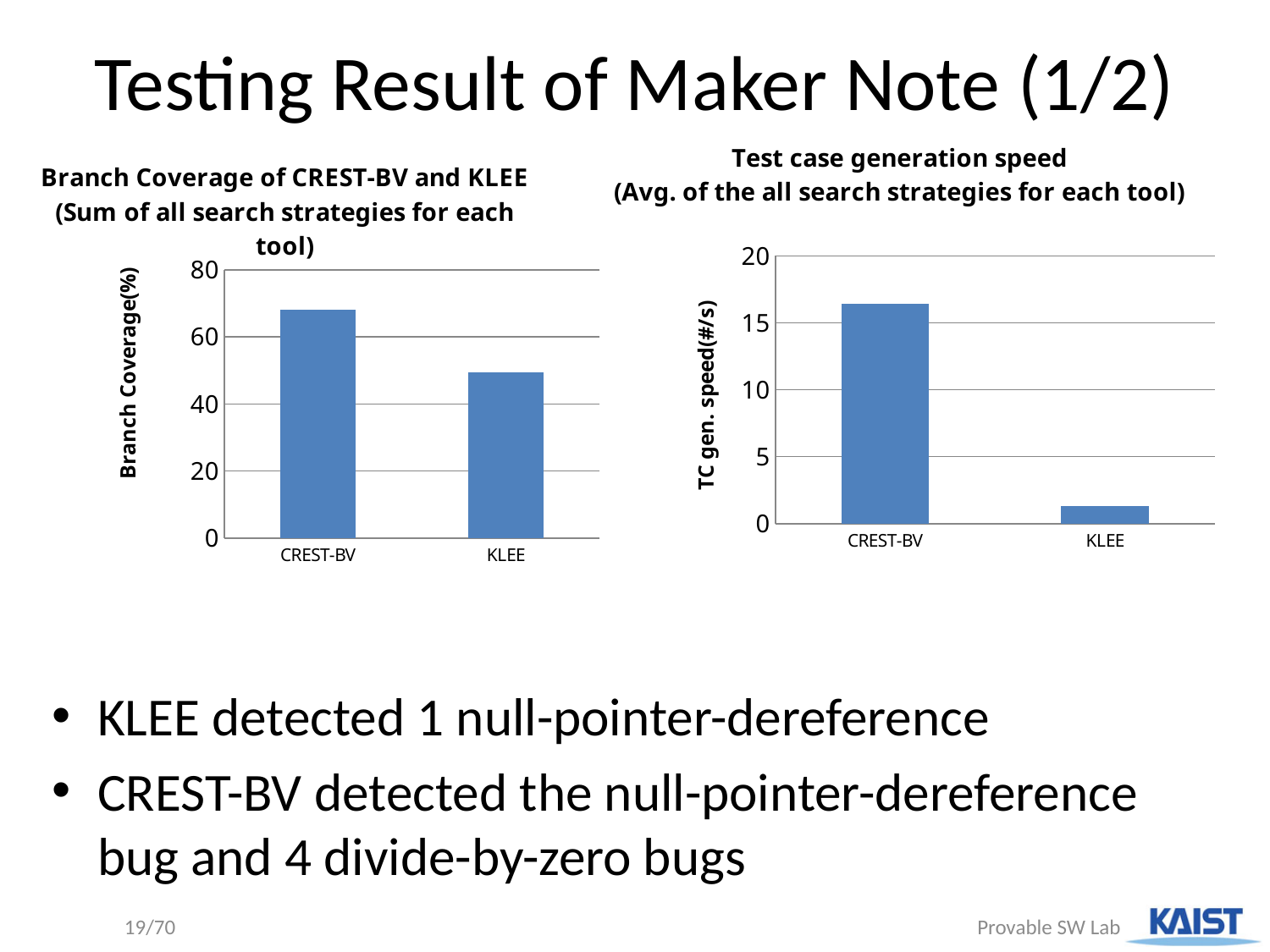
In the Test case generation speed chart, which is larger, the value for CREST-BV or the value for KLEE? CREST-BV What kind of chart is the Test case generation speed chart? Bar chart In the Test case generation speed chart, which tool has the higher TC generation speed? CREST-BV In the Branch Coverage chart, is the value for CREST-BV greater or less than 60? greater In the Branch Coverage chart, is the value for KLEE greater or less than 60? less In the Branch Coverage chart, which tool has the higher branch coverage? CREST-BV In the Branch Coverage chart, which tool has the lower branch coverage? KLEE How many tools are compared in the Branch Coverage chart? 2 In the Branch Coverage chart, is the value for KLEE greater or less than 40? greater What is the y-axis label of the Test case generation speed chart? TC gen. speed(#/s)